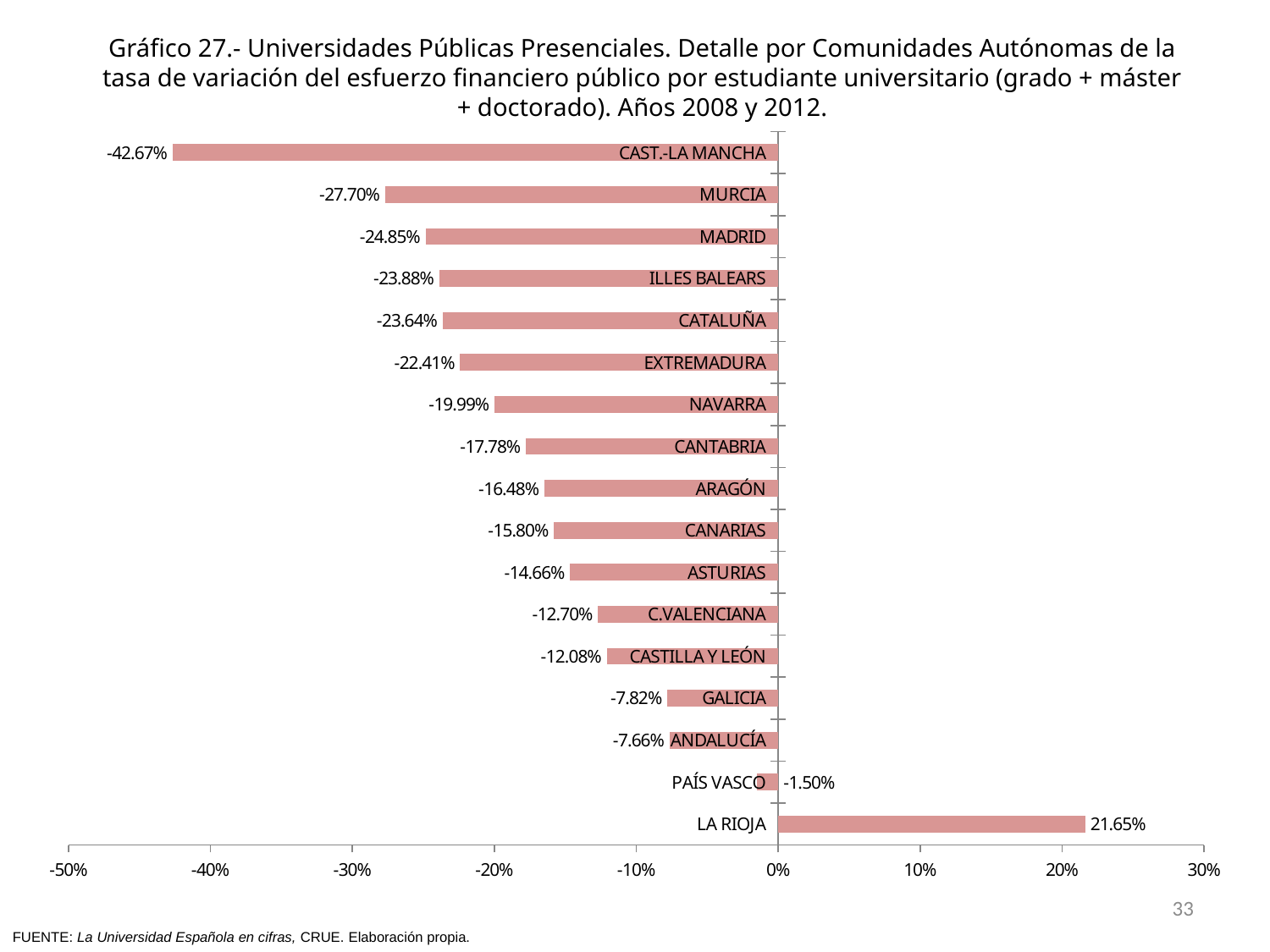
What is the value for LA RIOJA? 21.65% What is the value for MURCIA? -27.70% What is the value for NAVARRA? -19.99% Which community has the highest value? LA RIOJA Which community has the lowest value? CAST.-LA MANCHA Is the value for CAST.-LA MANCHA greater or less than -40%? less Which community is the only one with a positive value? LA RIOJA Which has a larger value, GALICIA or ANDALUCÍA? ANDALUCÍA What is the value for PAÍS VASCO? -1.50% What is the difference between the values for MADRID and MURCIA? 2.85 percentage points What kind of chart is shown on the slide? bar chart How many communities are shown in the chart? 17